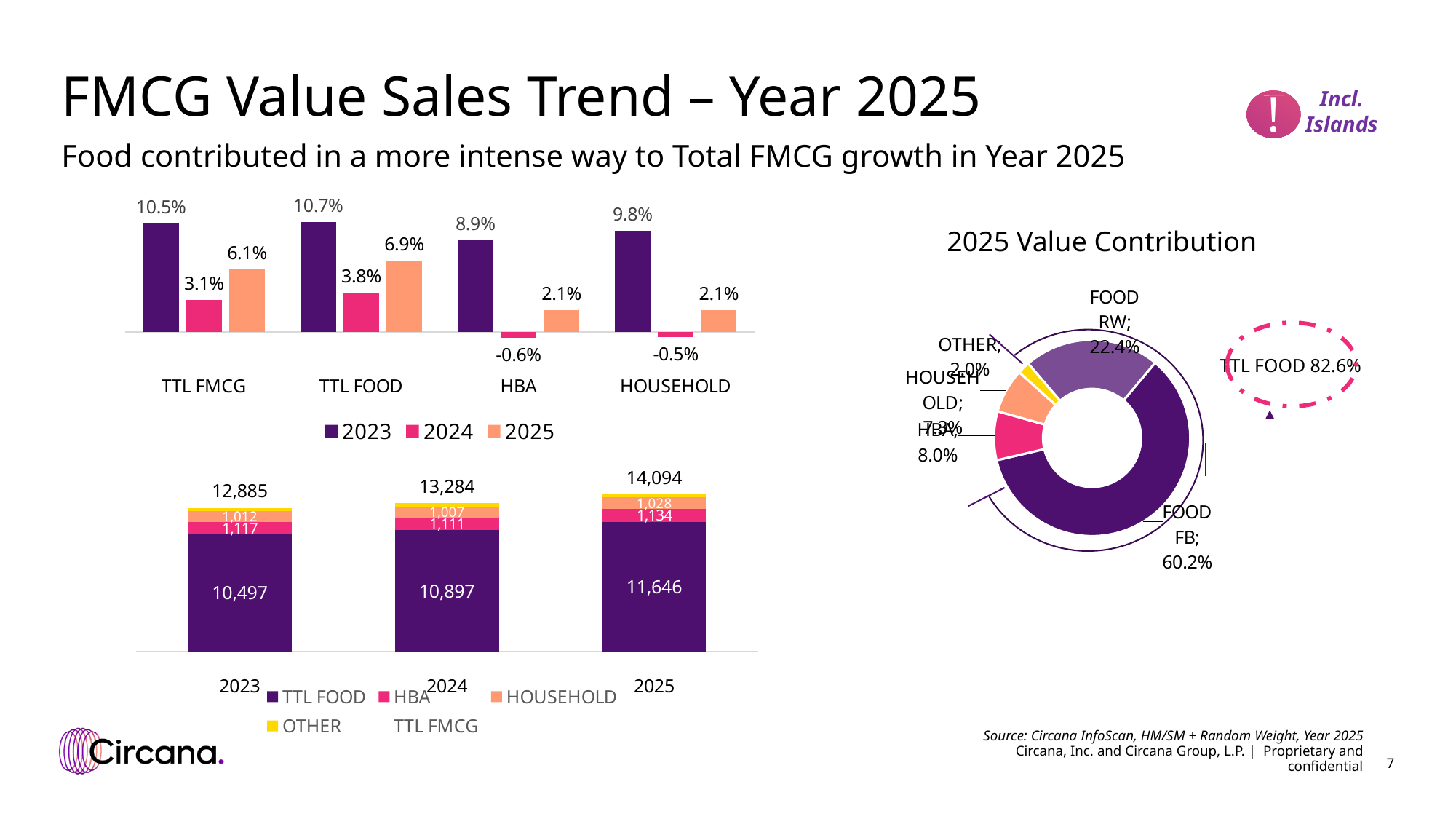
In the bottom-left stacked bar chart, what is the TTL FOOD value for 2025? 11,646 In the top-left bar chart, which category has the highest 2023 value? TTL FOOD In the 2025 Value Contribution chart, what share does FOOD FB have? 60.2% In the bottom-left stacked bar chart, what is the difference between the 2025 total and the 2023 total? 1,209 In the bottom-left stacked bar chart, what is the total of the 2024 bar? 13,284 In the bottom-left stacked bar chart, do the bar totals rise or fall from 2023 to 2025? rise In the top-left bar chart, what is the 2025 value for TTL FOOD? 6.9% In the top-left bar chart, what is the difference between the 2023 and 2025 values for TTL FMCG? 4.4 percentage points How many categories are shown on the x axis of the top-left bar chart? 4 In the top-left bar chart, what is the 2024 value for HBA? -0.6% How many series does the legend of the top-left bar chart list? 3 In the top-left bar chart, which is larger for 2025: TTL FMCG or TTL FOOD? TTL FOOD